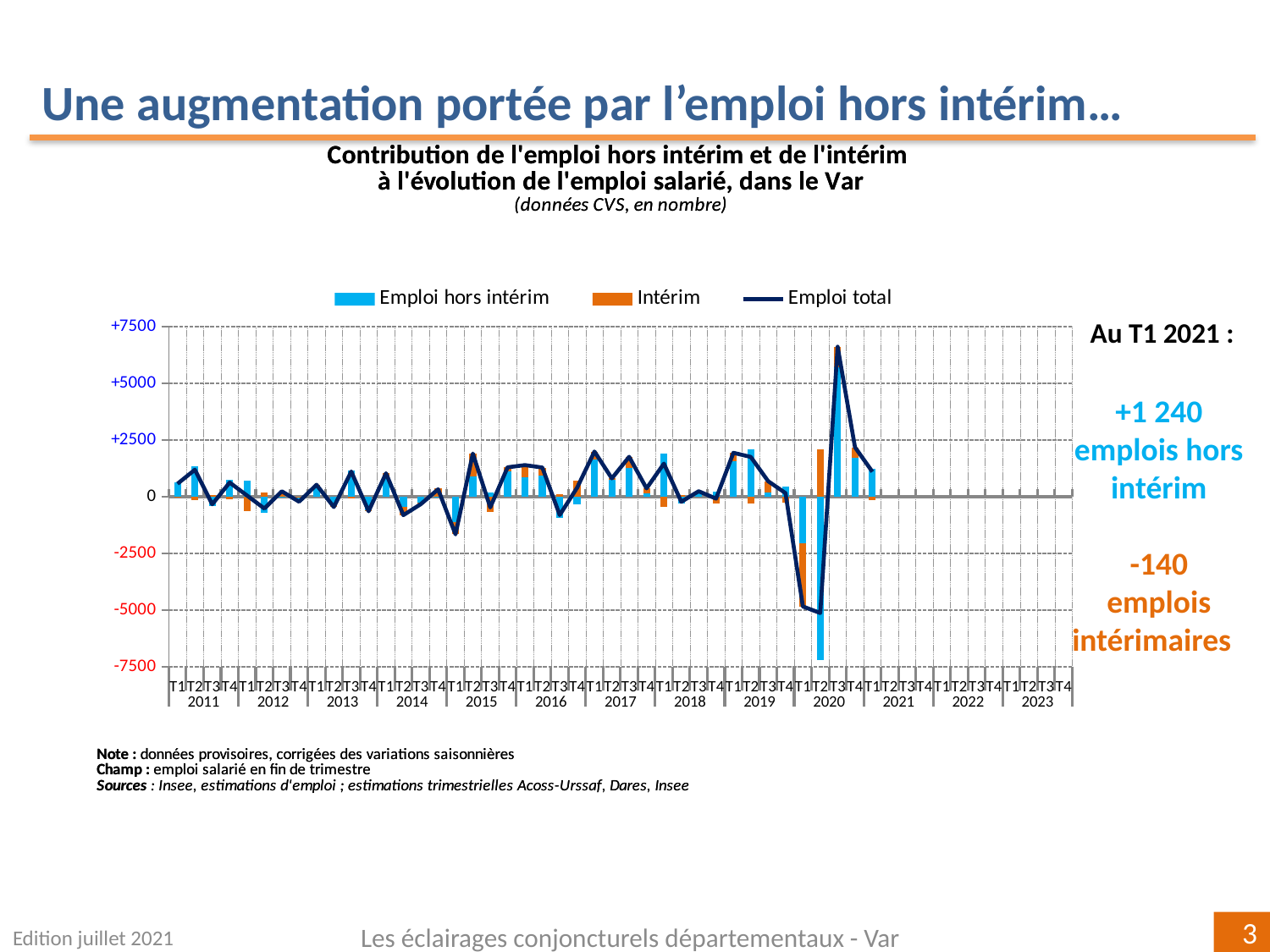
What is the difference between the Emploi hors intérim value (+1 240) and the Intérim value (-140) at T1 2021? 1 380 In which quarter does the Emploi hors intérim series reach its highest value? T3 2020 Which series is drawn as a dark line rather than bars? Emploi total What kind of chart is shown on the slide? A combined bar and line chart Is the value for Emploi hors intérim at T3 2020 greater or less than +5000? greater How many series does the chart legend list? 3 Is the value for Emploi total at T2 2020 greater or less than -2500? less Is the value for Emploi hors intérim at T2 2020 greater or less than -5000? less In which quarter does the Emploi hors intérim series reach its lowest value? T2 2020 At T1 2021, which is larger: the value for Emploi hors intérim or the value for Intérim? Emploi hors intérim According to the slide, what is the value for Intérim at T1 2021? -140 According to the slide, what is the value for Emploi hors intérim at T1 2021? +1 240